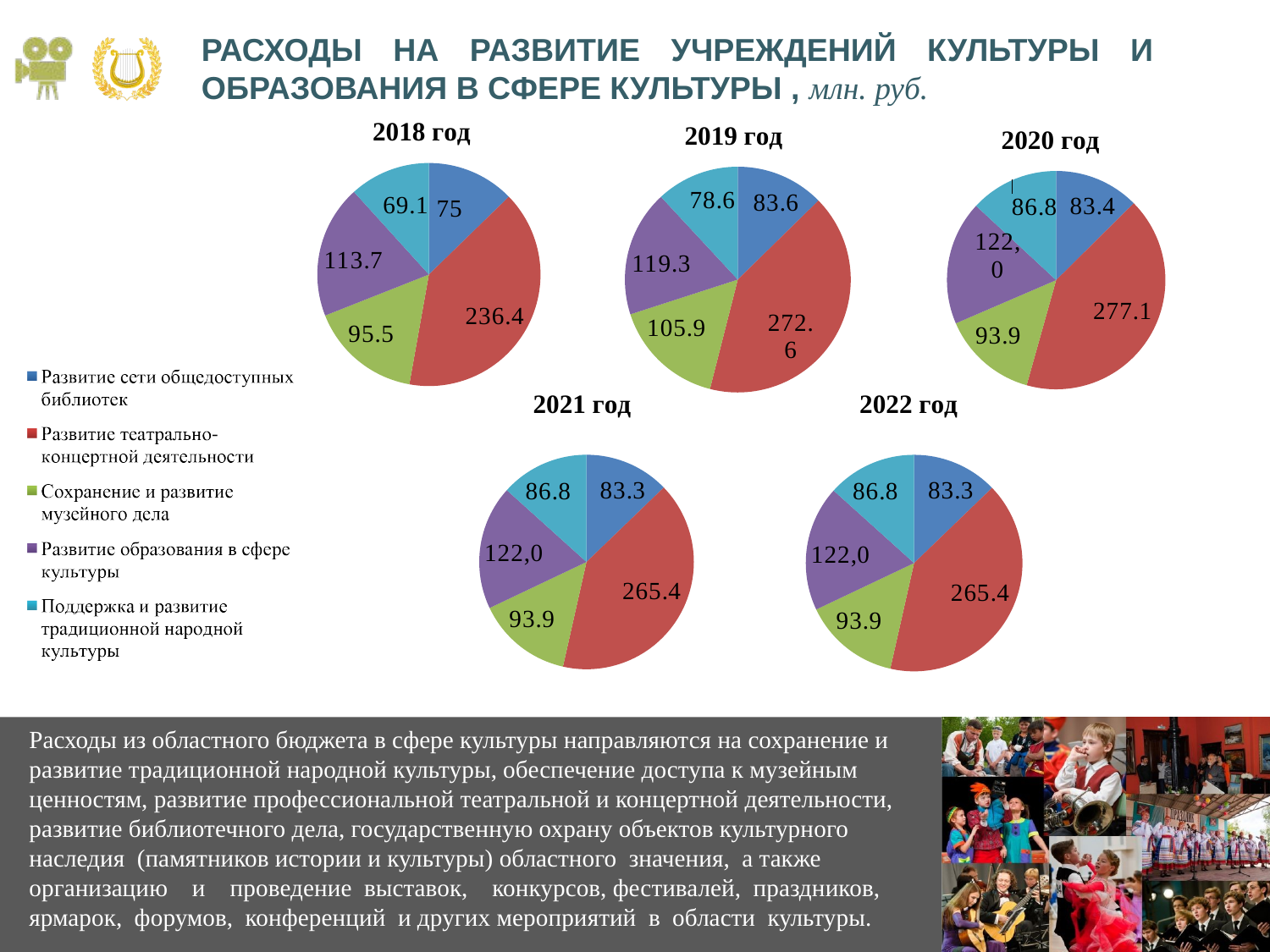
How many pie charts are shown on the slide? 5 In the 2021 год pie chart, what is the value for Сохранение и развитие музейного дела (the green slice)? 93.9 How many slices does the 2022 год pie chart have? 5 In the 2020 год pie chart, what is the value for Поддержка и развитие традиционной народной культуры (the teal slice)? 86.8 In the 2019 год pie chart, what is the value for Развитие сети общедоступных библиотек (the blue slice)? 83.6 In the 2018 год pie chart, what is the difference between Развитие образования в сфере культуры and Сохранение и развитие музейного дела? 18.2 What type of chart is used to show the 2020 год data? Pie chart What is the difference between the Развитие театрально-концертной деятельности value in the 2019 год chart and in the 2018 год chart? 36.2 In the 2018 год pie chart, which category has the smallest value? Поддержка и развитие традиционной народной культуры In the 2019 год pie chart, which is larger: Развитие образования в сфере культуры or Сохранение и развитие музейного дела? Развитие образования в сфере культуры In the 2018 год pie chart, which category has the largest value? Развитие театрально-концертной деятельности In the 2018 год pie chart, what is the value for Развитие театрально-концертной деятельности (the red slice)? 236.4